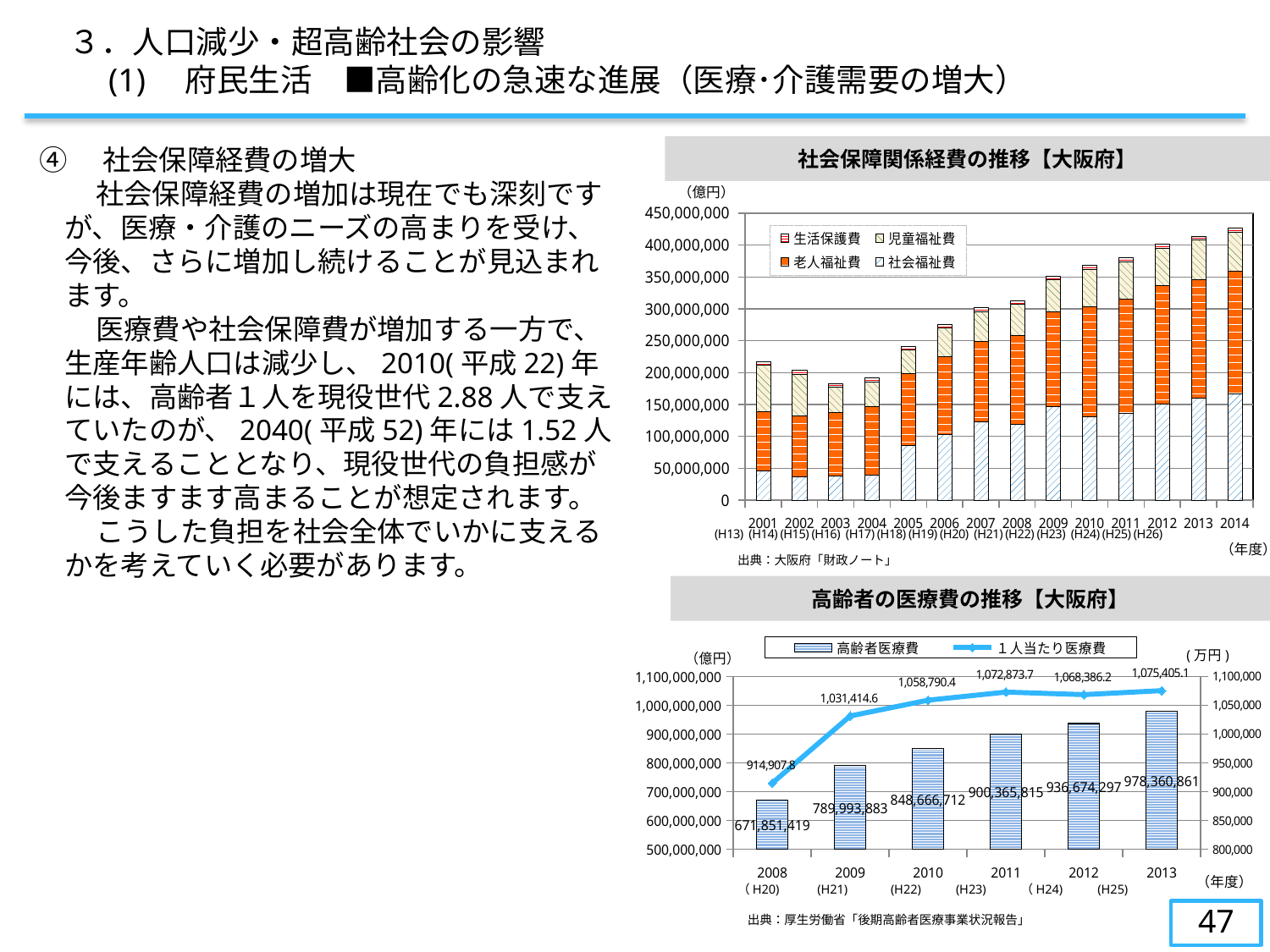
In the chart titled 社会保障関係経費の推移【大阪府】, which year has the highest total? 2014 In the chart titled 社会保障関係経費の推移【大阪府】, how many series does the legend list? 4 In the chart titled 高齢者の医療費の推移【大阪府】, what is the value of 高齢者医療費 for 2008? 671,851,419 In the chart titled 高齢者の医療費の推移【大阪府】, what is the value of 1人当たり医療費 for 2013? 1,075,405.1 In the chart titled 社会保障関係経費の推移【大阪府】, is the total for 2003 greater or less than 200,000,000? less In the chart titled 高齢者の医療費の推移【大阪府】, which year has the lowest 高齢者医療費? 2008 In the chart titled 社会保障関係経費の推移【大阪府】, what kind of chart is it? Stacked bar chart In the chart titled 社会保障関係経費の推移【大阪府】, how many years are shown on the x axis? 14 In the chart titled 社会保障関係経費の推移【大阪府】, is the total for 2014 greater or less than 400,000,000? greater In the chart titled 高齢者の医療費の推移【大阪府】, does 高齢者医療費 rise or fall from 2008 to 2013? Rise In the chart titled 高齢者の医療費の推移【大阪府】, is 1人当たり医療費 larger in 2011 or 2012? 2011 In the chart titled 高齢者の医療費の推移【大阪府】, what is the difference in 高齢者医療費 between 2013 and 2008? 306,509,442